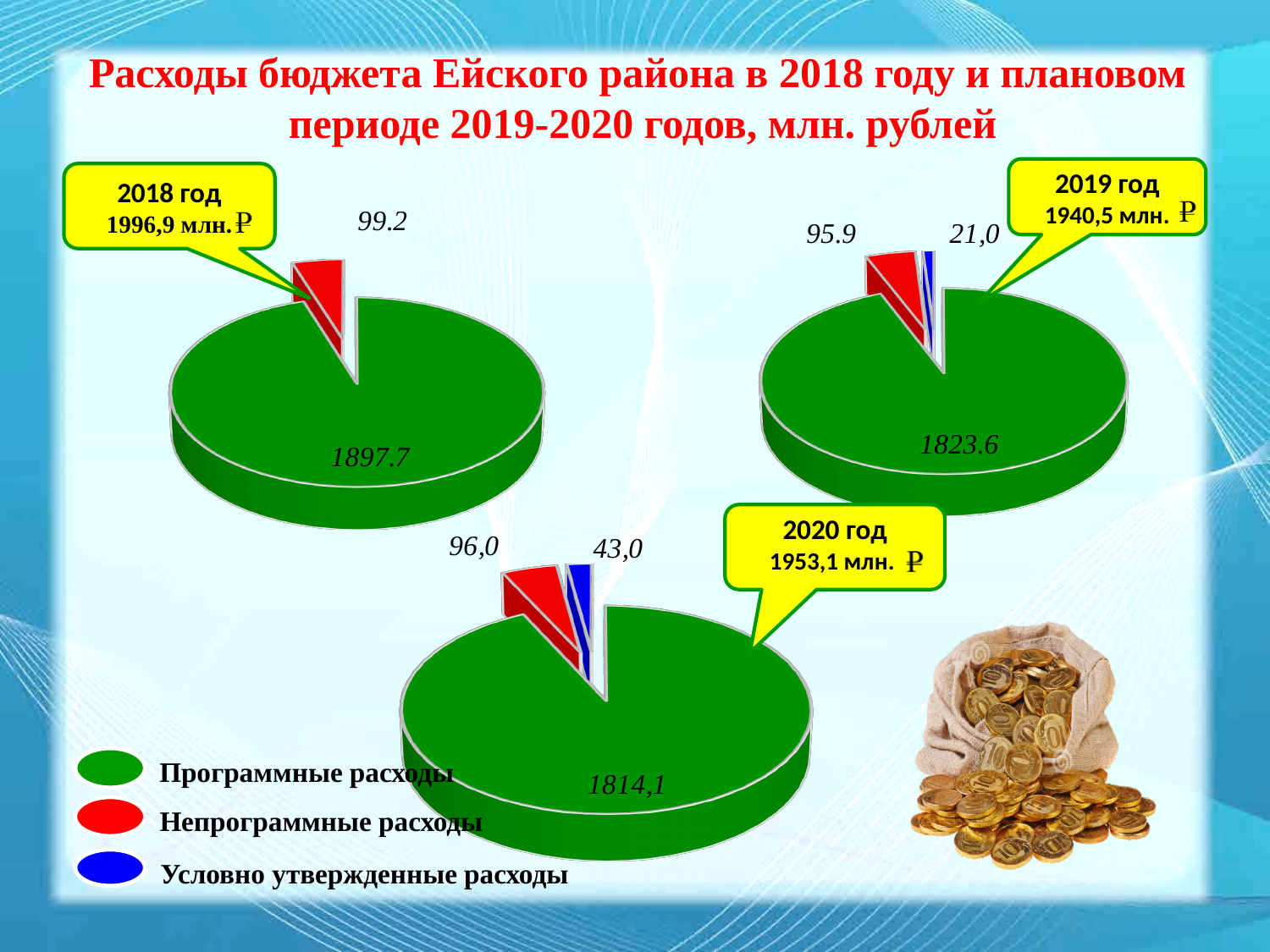
In the 2020 pie chart, what is the value for Непрограммные расходы (red slice)? 96,0 In the 2020 pie chart, what is the difference between Непрограммные расходы and Условно утвержденные расходы? 53,0 In the 2018 pie chart, what is the value for Программные расходы (green slice)? 1897.7 What type of chart is used on this slide? Pie chart In the 2019 pie chart, what is the value for Условно утвержденные расходы (blue slice)? 21,0 In the 2019 pie chart, which category has the largest slice? Программные расходы In the 2020 pie chart, what is the value for Программные расходы (green slice)? 1814,1 In the 2019 pie chart, which is larger: Непрограммные расходы or Условно утвержденные расходы? Непрограммные расходы In the 2020 pie chart, which category has the smallest slice? Условно утвержденные расходы According to the callout, what is the total budget expenditure for 2020? 1953,1 млн. ₽ In the 2018 pie chart, what is the value for Непрограммные расходы (red slice)? 99.2 How many slices does the 2019 pie chart have? 3